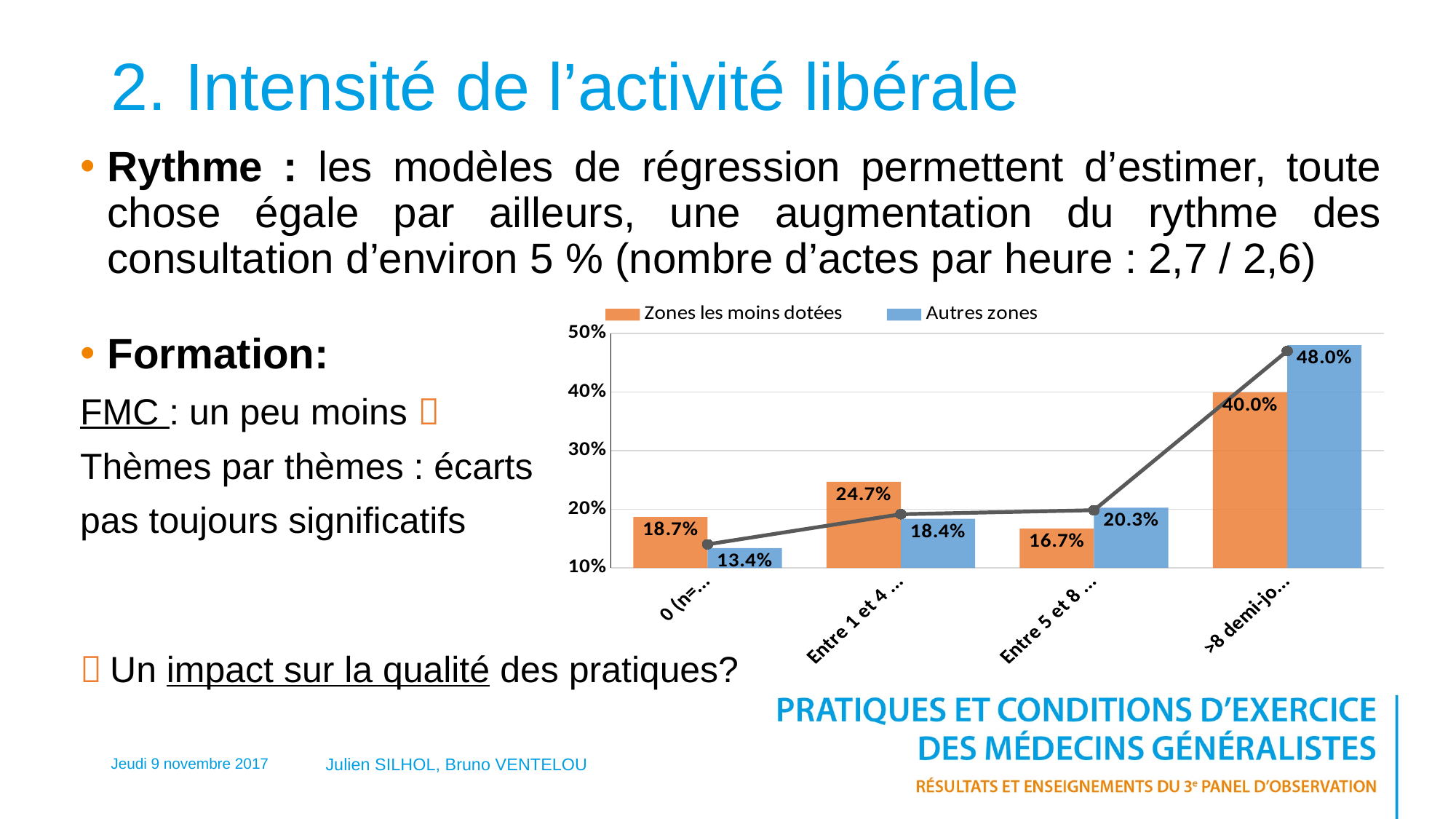
In the fourth category (>8 demi-jo…), what is the difference between the Autres zones value and the Zones les moins dotées value? 8.0 percentage points For which category is the Autres zones series lowest? The first category (0 (n=…)) What is the value of the Zones les moins dotées series for the first category (0 (n=…))? 18.7% Does the Autres zones series rise or fall from the first category to the last? Rise In the second category (Entre 1 et 4 …), which series has the larger value? Zones les moins dotées How many categories are shown on the x axis of the chart? 4 What is the value of the Zones les moins dotées series for the second category (Entre 1 et 4 …)? 24.7% How many series does the chart legend list? 2 What kind of chart is shown on the slide? A combination bar and line chart Is the Zones les moins dotées value for the fourth category (>8 demi-jo…) greater or less than 30%? greater For which category is the Autres zones series highest? The fourth category (>8 demi-jo…) What is the value of the Autres zones series for the fourth category (>8 demi-jo…)? 48.0%